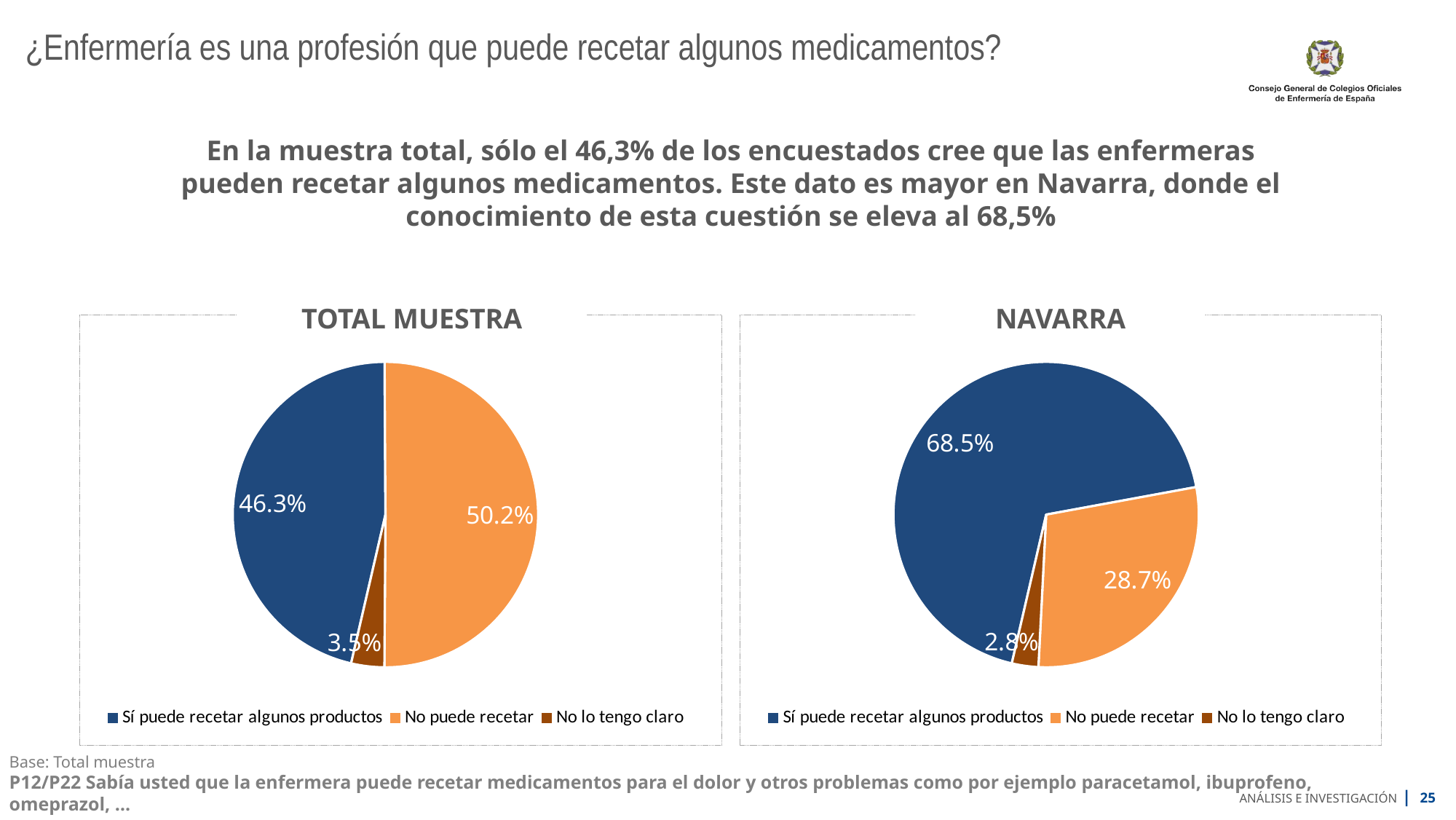
In the NAVARRA chart, what colour is the 'No puede recetar' slice? Orange In the NAVARRA chart, what share of respondents answered 'Sí puede recetar algunos productos'? 68.5% In the NAVARRA chart, which category has the smallest slice? No lo tengo claro In the NAVARRA chart, what share of respondents answered 'No lo tengo claro'? 2.8% In the TOTAL MUESTRA chart, what share of respondents answered 'No puede recetar'? 50.2% In the TOTAL MUESTRA chart, which category has the largest slice? No puede recetar In the TOTAL MUESTRA chart, what is the difference between the 'No puede recetar' and 'No lo tengo claro' shares? 46.7% How many categories does the NAVARRA pie chart have? 3 What type of chart is used for TOTAL MUESTRA? Pie chart In the TOTAL MUESTRA chart, what share of respondents answered 'Sí puede recetar algunos productos'? 46.3% What is the difference between the 'Sí puede recetar algunos productos' share in the NAVARRA chart and in the TOTAL MUESTRA chart? 22.2% Which chart shows a larger share for 'No puede recetar', TOTAL MUESTRA or NAVARRA? TOTAL MUESTRA